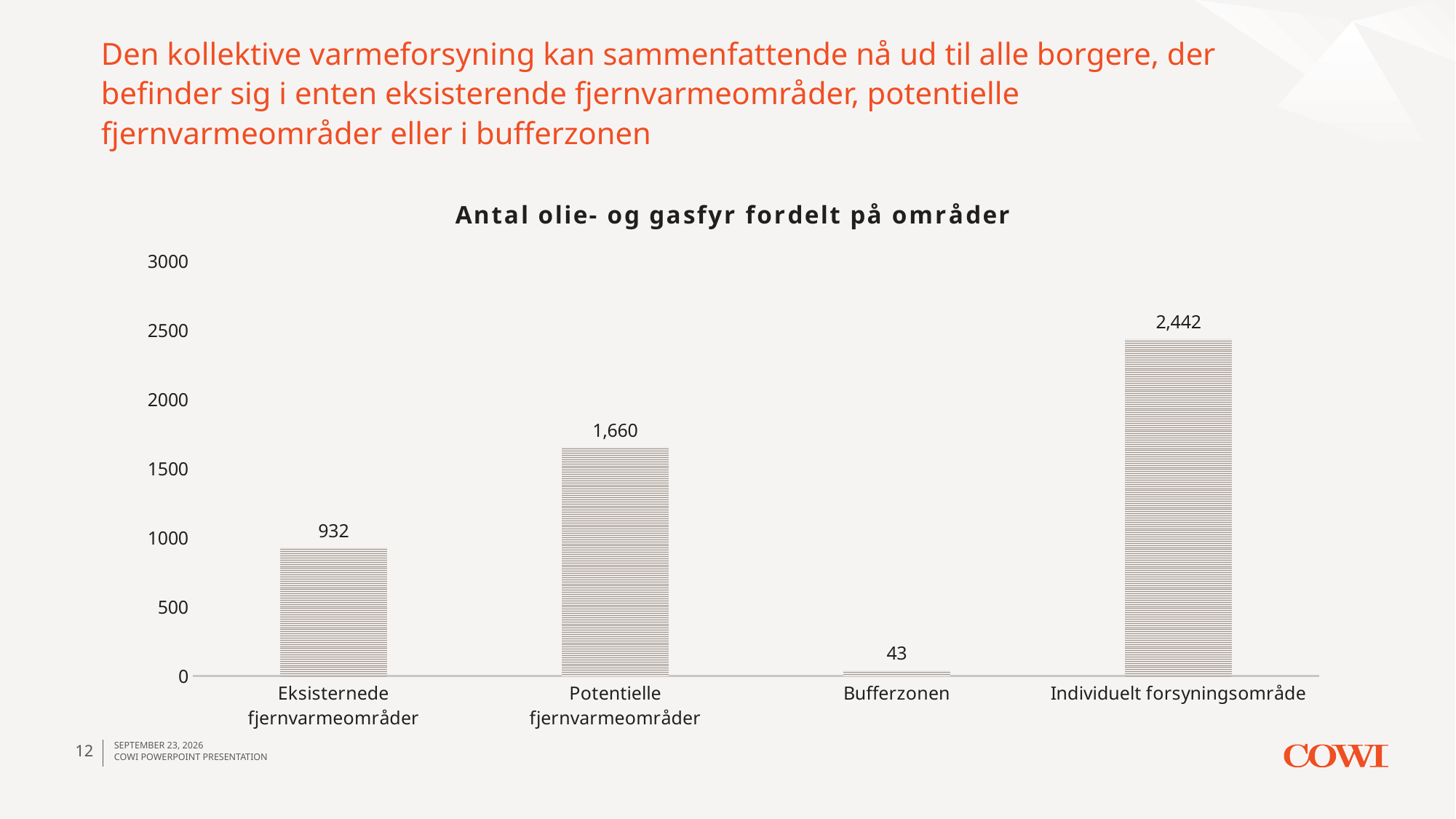
Which category has the lowest value? Bufferzonen What is the difference between the values for Potentielle fjernvarmeområder and Eksisternede fjernvarmeområder? 728 What is the value for Eksisternede fjernvarmeområder? 932 What is the value for Potentielle fjernvarmeområder? 1,660 Which category has the highest value? Individuelt forsyningsområde How many categories are shown on the x axis? 4 What type of chart is shown on the slide? bar chart What is the difference between the values for Individuelt forsyningsområde and Potentielle fjernvarmeområder? 782 Is the value for Eksisternede fjernvarmeområder greater or less than 1000? less What is the value for Individuelt forsyningsområde? 2,442 What is the value for Bufferzonen? 43 Which is larger, the value for Eksisternede fjernvarmeområder or the value for Potentielle fjernvarmeområder? Potentielle fjernvarmeområder